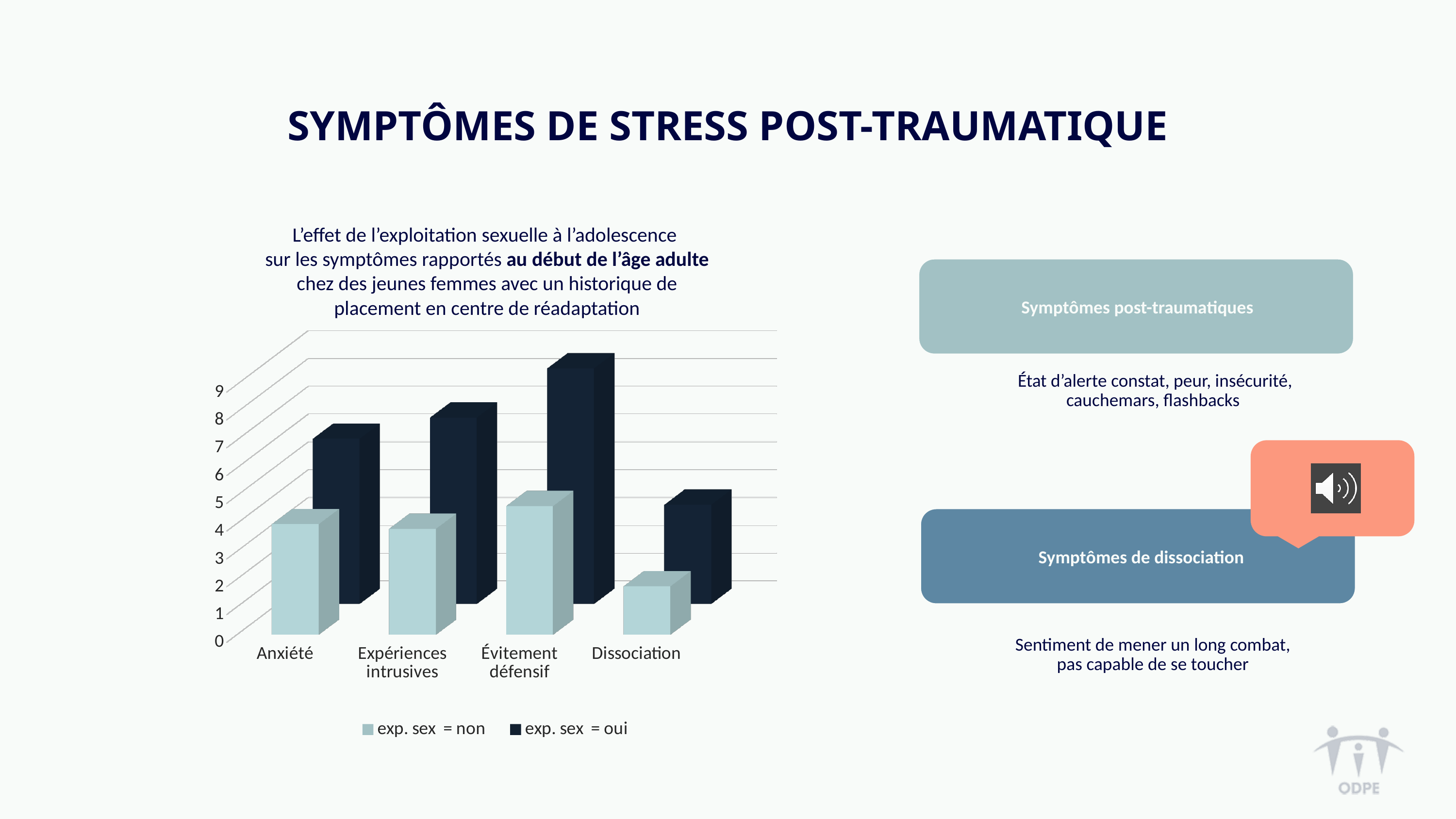
For Anxiété, which series has the larger value: 'exp. sex = non' or 'exp. sex = oui'? exp. sex = oui How many categories are shown on the x axis of the chart? 4 How many series does the chart legend list? 2 Is the value for Évitement défensif in the 'exp. sex = oui' series greater or less than 8? greater Which category has the highest value for the 'exp. sex = oui' series? Évitement défensif What are the two legend entries of the chart? exp. sex = non; exp. sex = oui What kind of chart is shown on the slide? bar chart Which category has the lowest value for the 'exp. sex = non' series? Dissociation Is the value for Dissociation in the 'exp. sex = non' series greater or less than 3? less Which category has the lowest value for the 'exp. sex = oui' series? Dissociation Which category has the highest value for the 'exp. sex = non' series? Évitement défensif